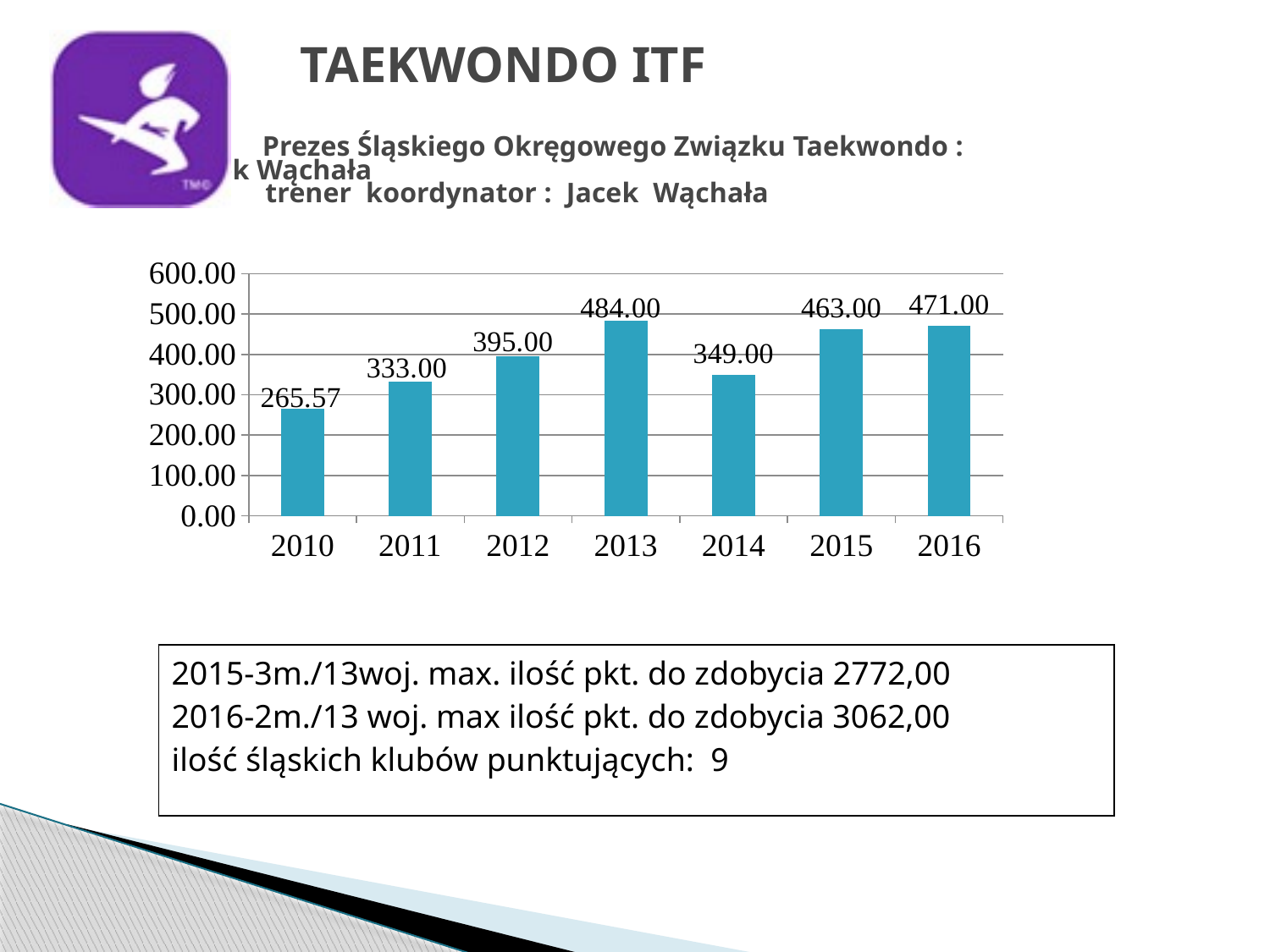
What is the value for 2016? 471.00 What is the value for 2010? 265.57 Which year has the lowest value? 2010 What kind of chart is shown on the slide? bar chart Which year has the highest value? 2013 Is the value for 2011 greater or less than 300.00? greater How many years are shown on the x axis? 7 What is the difference between the values for 2013 and 2014? 135.00 What is the value for 2013? 484.00 Which is larger, the value for 2012 or the value for 2014? 2012 What is the difference between the values for 2016 and 2015? 8.00 Does the value rise or fall from 2013 to 2014? fall